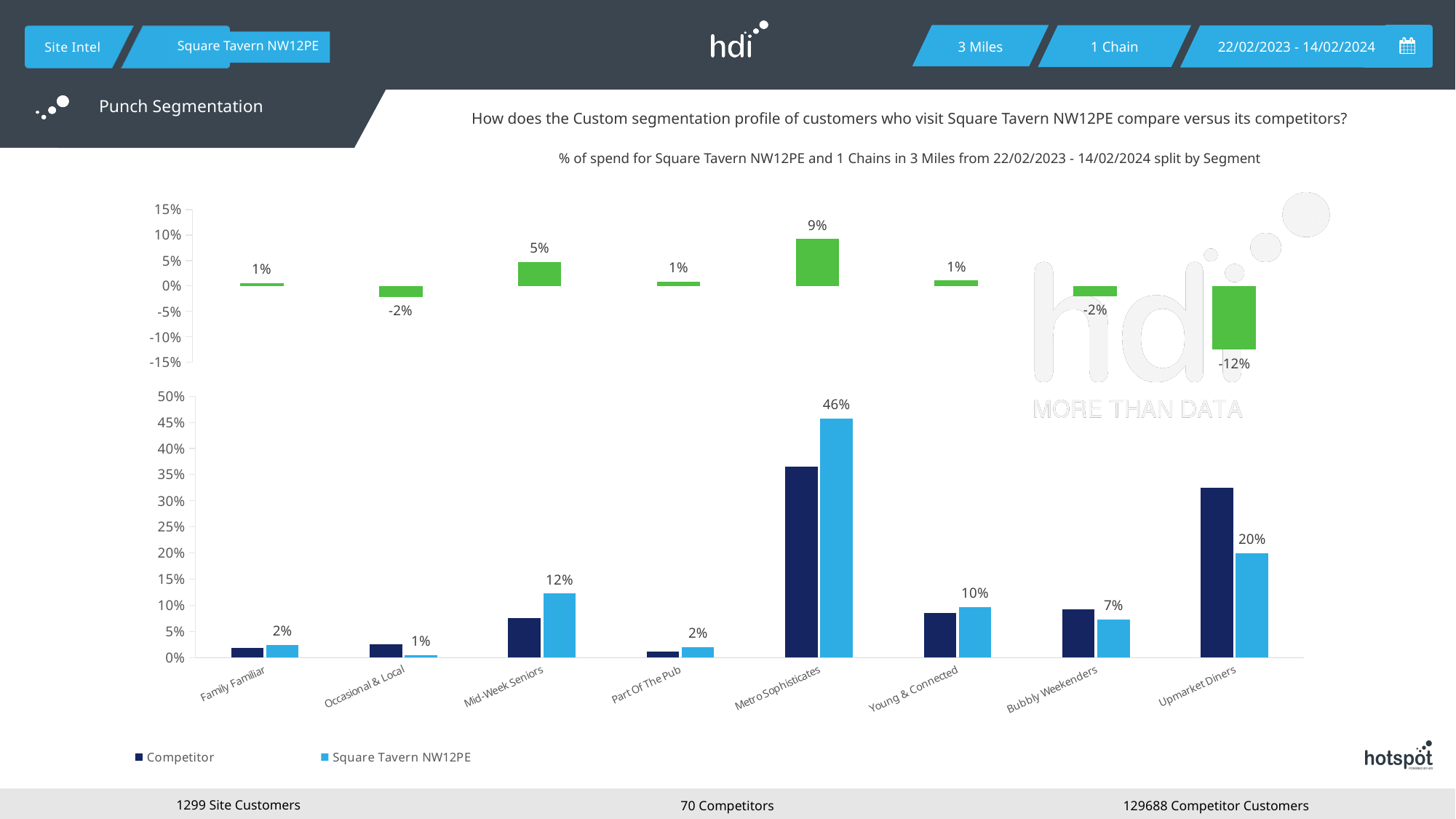
In the top chart, which segment has the highest value? Metro Sophisticates In the top chart, what is the value shown for Upmarket Diners? -12% In the top chart, what is the difference between the values for Metro Sophisticates and Mid-Week Seniors? 4% In the bottom chart, which segment has the lowest Square Tavern NW12PE value? Occasional & Local How many series does the legend of the bottom chart list? 2 In the bottom chart, for Upmarket Diners, which is larger: the Competitor value or the Square Tavern NW12PE value? Competitor In the top chart, which segment has the lowest value? Upmarket Diners How many segments are shown on the x axis of the bottom chart? 8 In the bottom chart, is the Competitor value for Metro Sophisticates greater or less than 30%? greater In the bottom chart, what is the value for Square Tavern NW12PE in the Upmarket Diners segment? 20% In the bottom chart, what is the difference between the Square Tavern NW12PE values for Metro Sophisticates and Upmarket Diners? 26% In the bottom chart, what is the value for Square Tavern NW12PE in the Metro Sophisticates segment? 46%